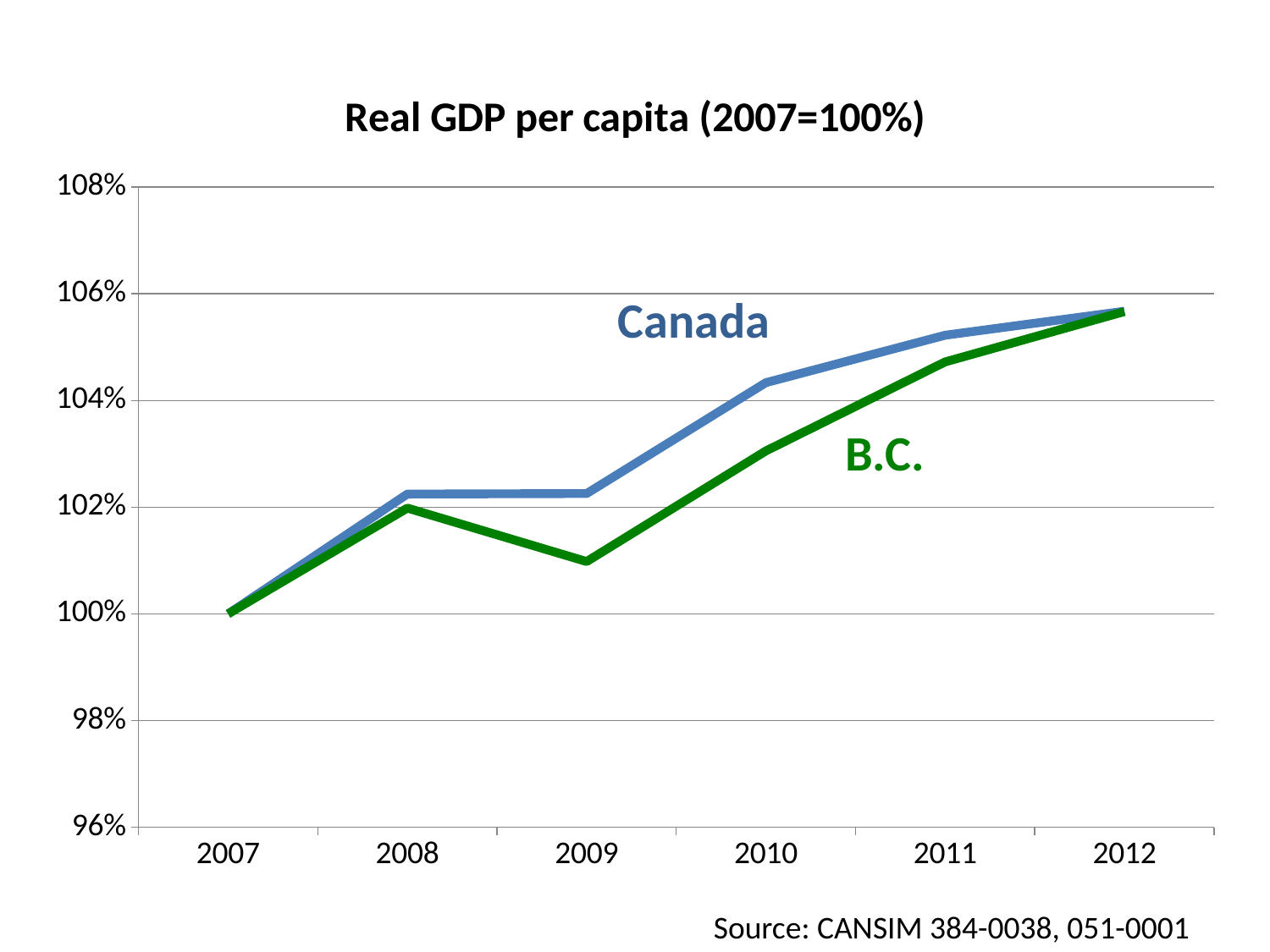
What kind of chart is shown on the slide? Line chart Is the value for B.C. in 2010 greater or less than 104%? less What is the title of the chart? Real GDP per capita (2007=100%) Which series is higher in 2009, Canada or B.C.? Canada Does the Canada line rise or fall from 2007 to 2012? Rises Is the value for Canada in 2011 greater or less than 106%? less Is the value for B.C. in 2009 greater or less than 102%? less What is the value for Canada in 2007? 100% How many years are shown along the x axis? 6 Which series is higher in 2010, Canada or B.C.? Canada What is the value for B.C. in 2007? 100% How many series are plotted on the chart? 2